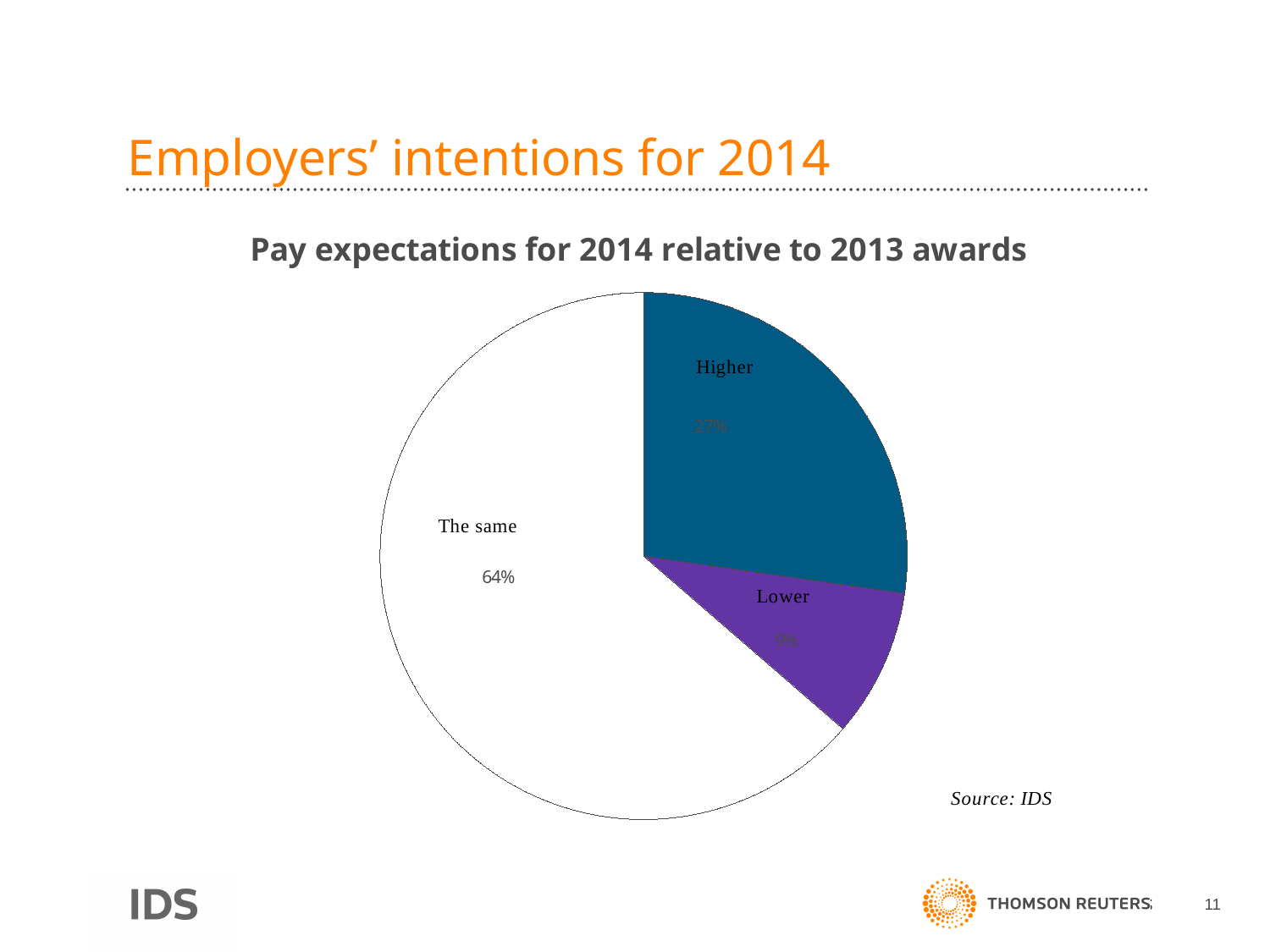
What source is cited for the chart? IDS How many slices does the pie chart have? 3 What kind of chart is shown on the slide? pie chart What is the difference in percentage points between 'Higher' and 'Lower'? 18 What share of the pie is labelled 'Higher'? 27% Which slice of the pie is the smallest? Lower Which slice of the pie is the largest? The same What is the title of the chart? Pay expectations for 2014 relative to 2013 awards What share of the pie is labelled 'The same'? 64% What is the difference in percentage points between 'The same' and 'Higher'? 37 Which is larger, the 'Higher' slice or the 'Lower' slice? Higher What share of the pie is labelled 'Lower'? 9%